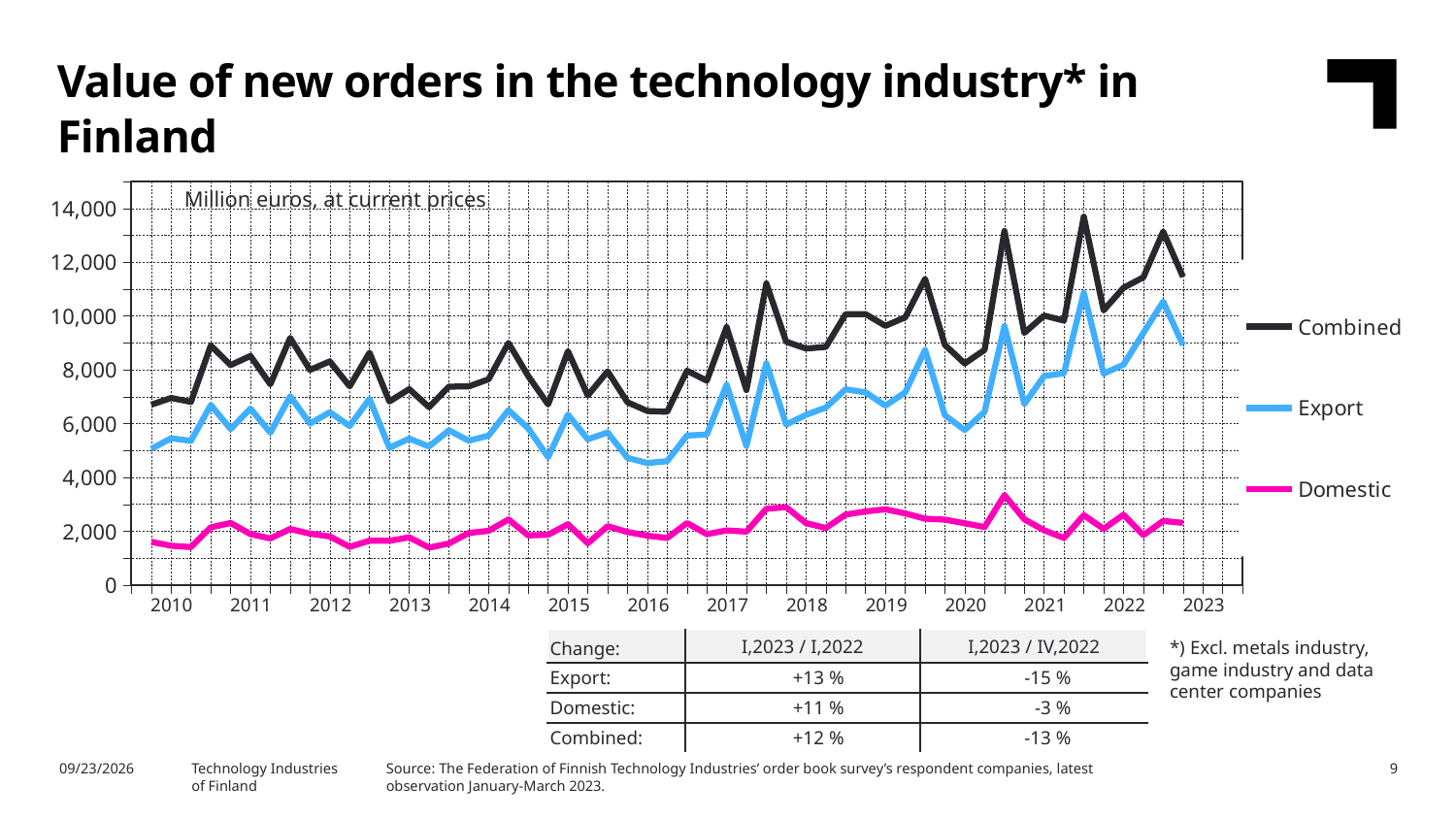
Which is larger in 2020: the Export series or the Domestic series? Export Is the value of the Domestic series at any point greater or less than 4,000? less Which series has the highest values throughout the chart? Combined What are the three series named in the chart legend? Combined, Export, Domestic Does the Combined series overall rise or fall from 2010 to 2023? Rise Is the value of the Export series in 2016 greater or less than 6,000? less Which series has the lowest values throughout the chart? Domestic How many year labels are shown along the x axis of the chart? 14 In what unit are the values on the chart expressed, according to the label inside the plot area? Million euros, at current prices How many series does the chart legend list? 3 Is the peak value of the Combined series around 2021 greater or less than 12,000? greater What kind of chart is shown on the slide? Line chart